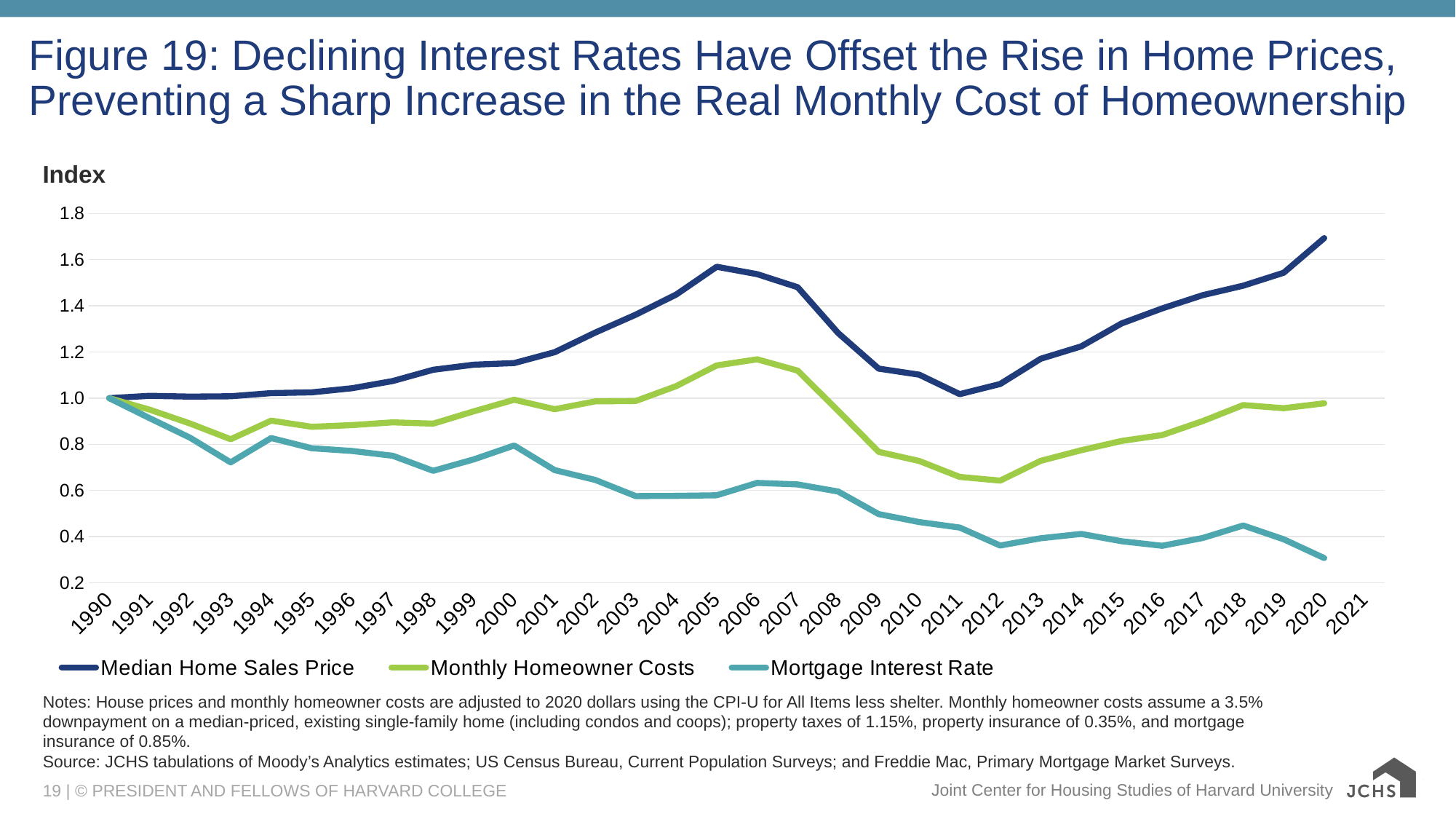
Which series has the highest value in 2020? Median Home Sales Price What is the value of the Median Home Sales Price index in 1990? 1.0 Is the value for Mortgage Interest Rate in 2020 greater or less than 0.4? less What is the value of the Mortgage Interest Rate index in 1990? 1.0 How many series does the legend list? 3 Which is larger: the Median Home Sales Price index in 2005 or in 2011? 2005 In which year does the Median Home Sales Price line reach its highest value? 2020 Is the value for Median Home Sales Price in 2020 greater or less than 1.6? greater Does the Mortgage Interest Rate line generally rise or fall from 1990 to 2020? Fall Is the value for Monthly Homeowner Costs in 2012 greater or less than 0.8? less Which series has the lowest value in 2020? Mortgage Interest Rate What kind of chart is shown on the slide? Line chart